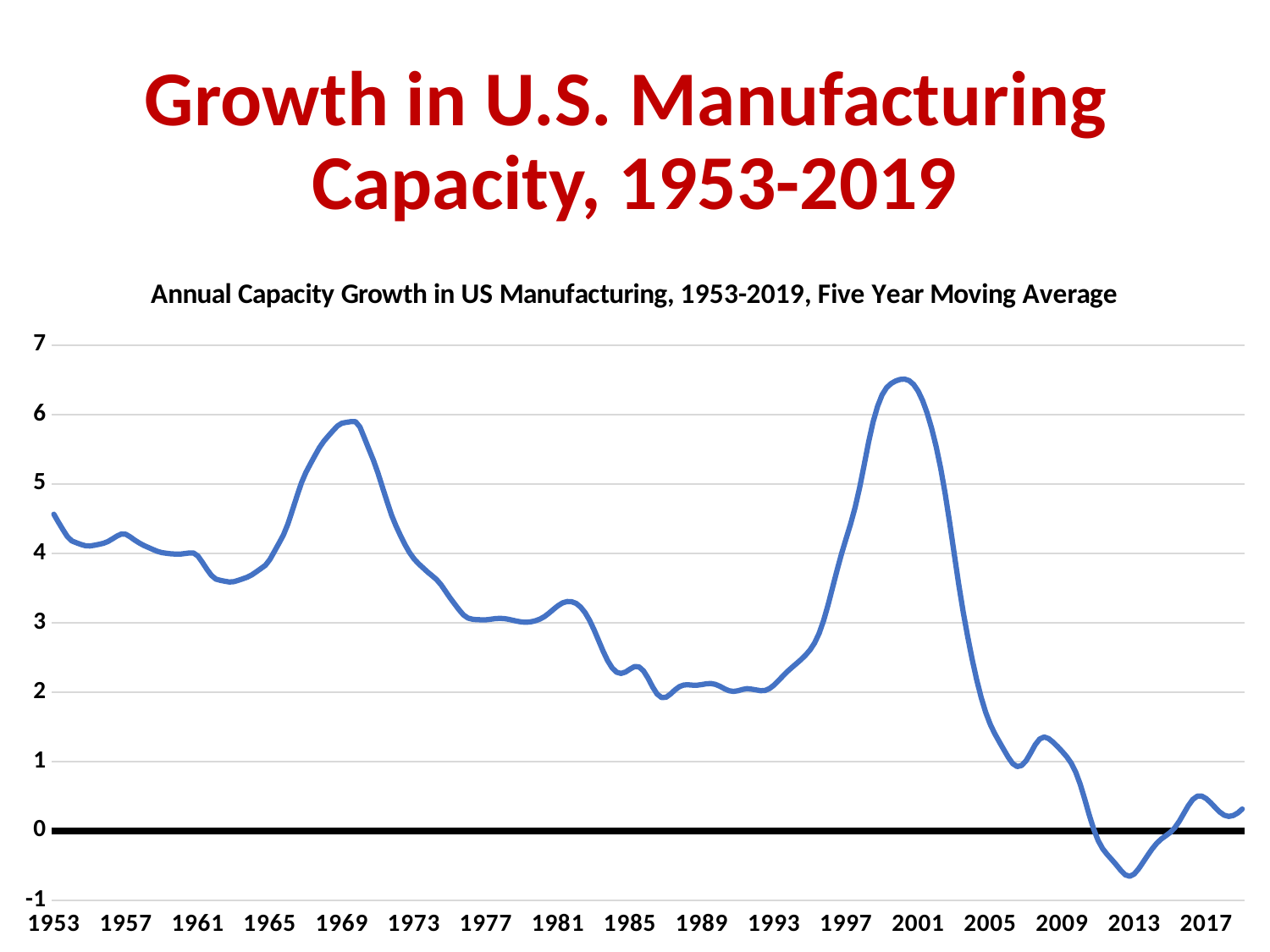
Between 1993 and 2001, does the line rise or fall? rise Is the value for 2001 greater or less than 6? greater Around which labeled year does the line reach its lowest value? 2013 What kind of chart is shown on the slide? line chart Which is larger: the value for 1953 or the value for 2017? 1953 Is the value for 1969 greater or less than 5? greater Overall, does the line rise or fall from 1953 to 2019? fall What is the title printed above the chart? Annual Capacity Growth in US Manufacturing, 1953-2019, Five Year Moving Average Is the value for 1989 greater or less than 3? less Which is higher: the peak of the line around 1969 or the peak around 2001? the peak around 2001